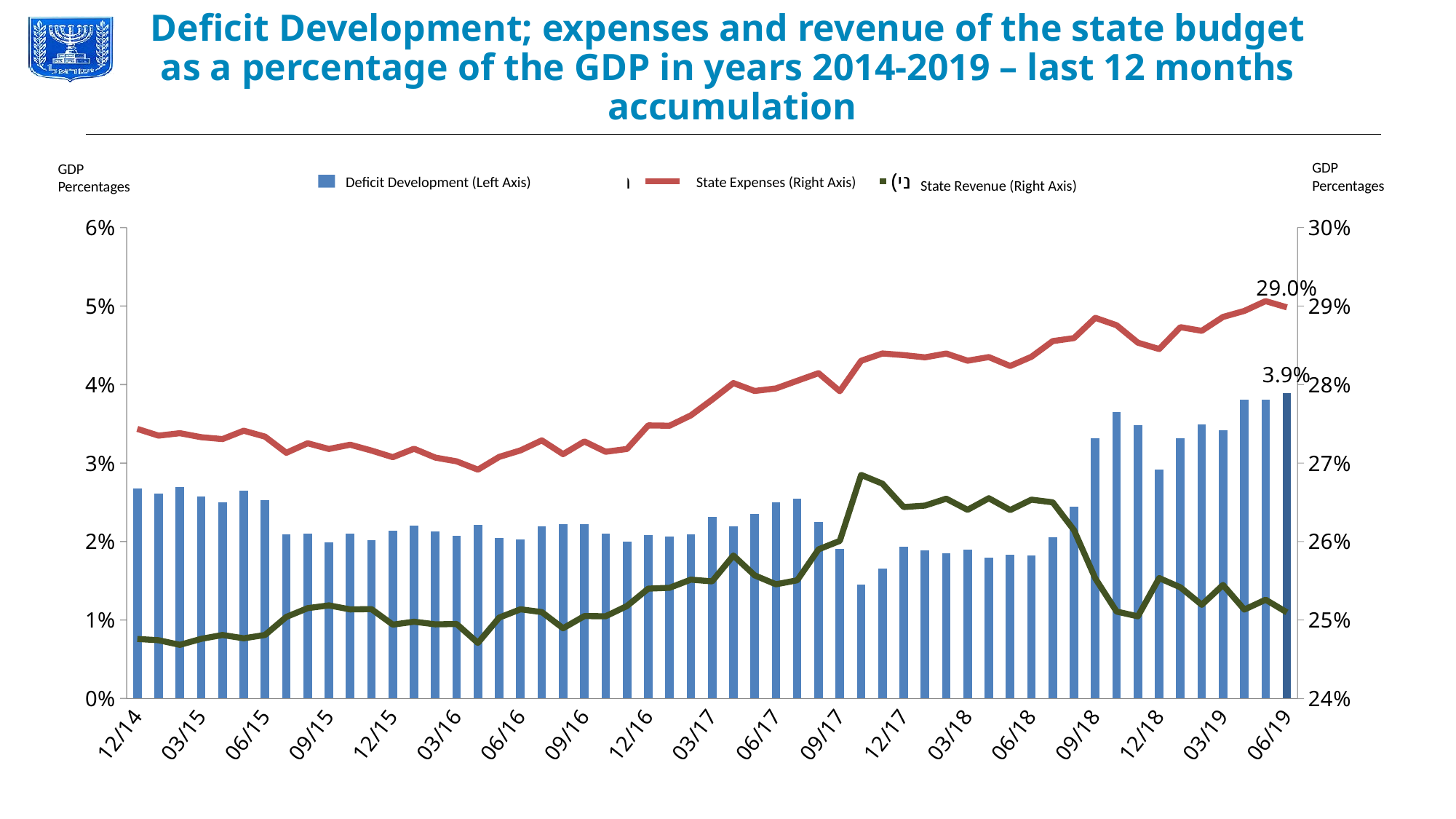
Is the State Revenue value for 06/19 greater or less than 26%? less How many series does the legend list? 3 Is the Deficit Development value for 12/14 greater or less than 2%? greater Does the State Expenses line generally rise or fall from 12/14 to 06/19? rise What kind of chart is shown on the slide? Combined bar and line chart Which is larger at 06/19: State Expenses or State Revenue? State Expenses What is the Deficit Development value shown for 06/19? 3.9% Is the State Revenue value for 12/14 greater or less than 26%? less On which axis is the Deficit Development series plotted? Left axis What is the State Expenses value shown for 06/19? 29.0%